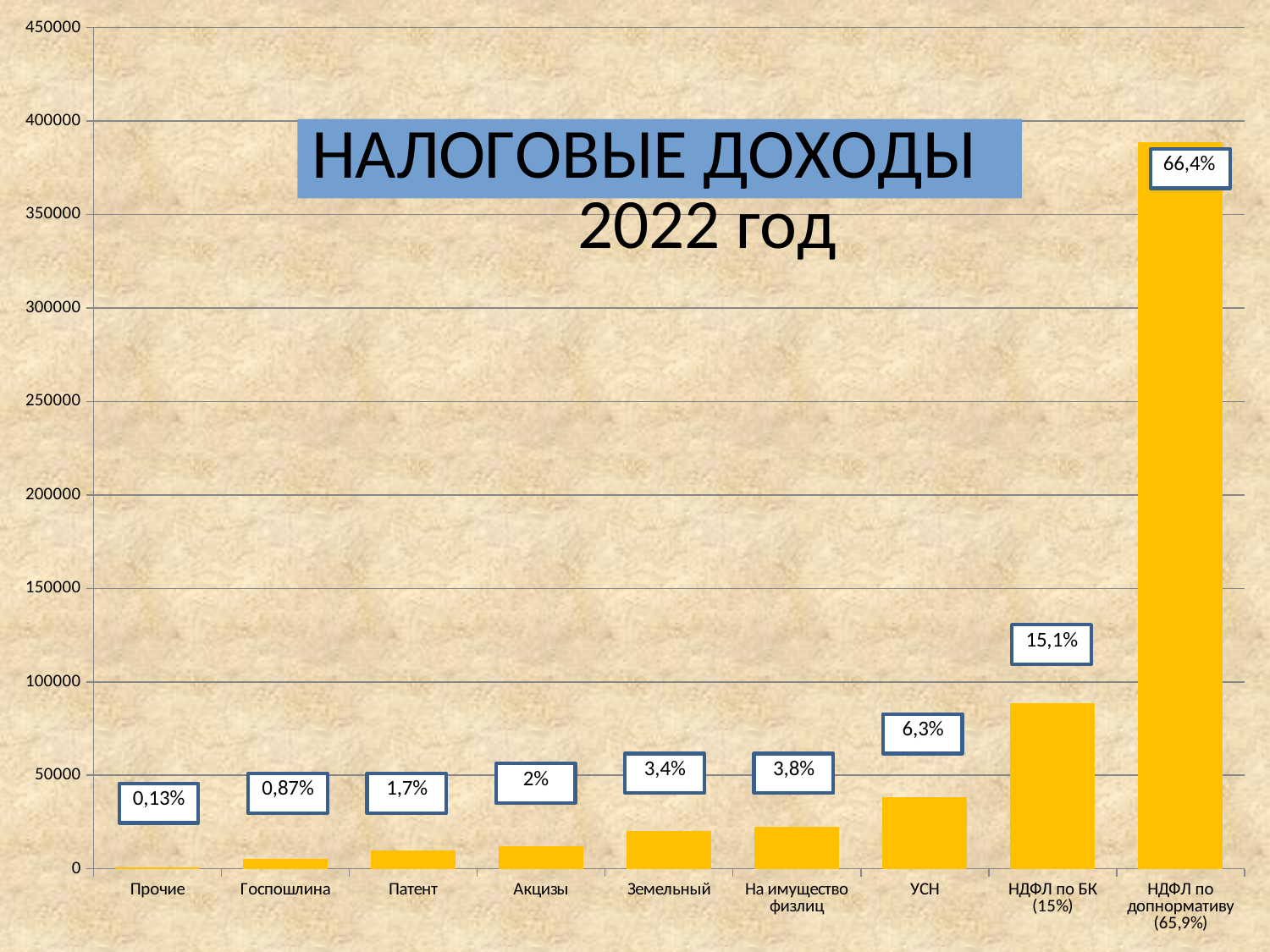
What percentage label is shown above the bar for Госпошлина? 0,87% What percentage label is shown above the bar for НДФЛ по допнормативу? 66,4% Which category has the lowest bar in the chart? Прочие How many categories are shown on the x axis of the chart? 9 What kind of chart is shown on the slide? bar chart Do the bar values rise or fall from left to right along the x axis? rise What percentage label is shown above the bar for УСН? 6,3% Which bar is taller, УСН or Акцизы? УСН Is the value for НДФЛ по БК greater or less than 100000? less Is the value for НДФЛ по допнормативу greater or less than 350000? greater Which category has the highest bar in the chart? НДФЛ по допнормативу (65,9%) What percentage label is shown above the bar for Земельный? 3,4%